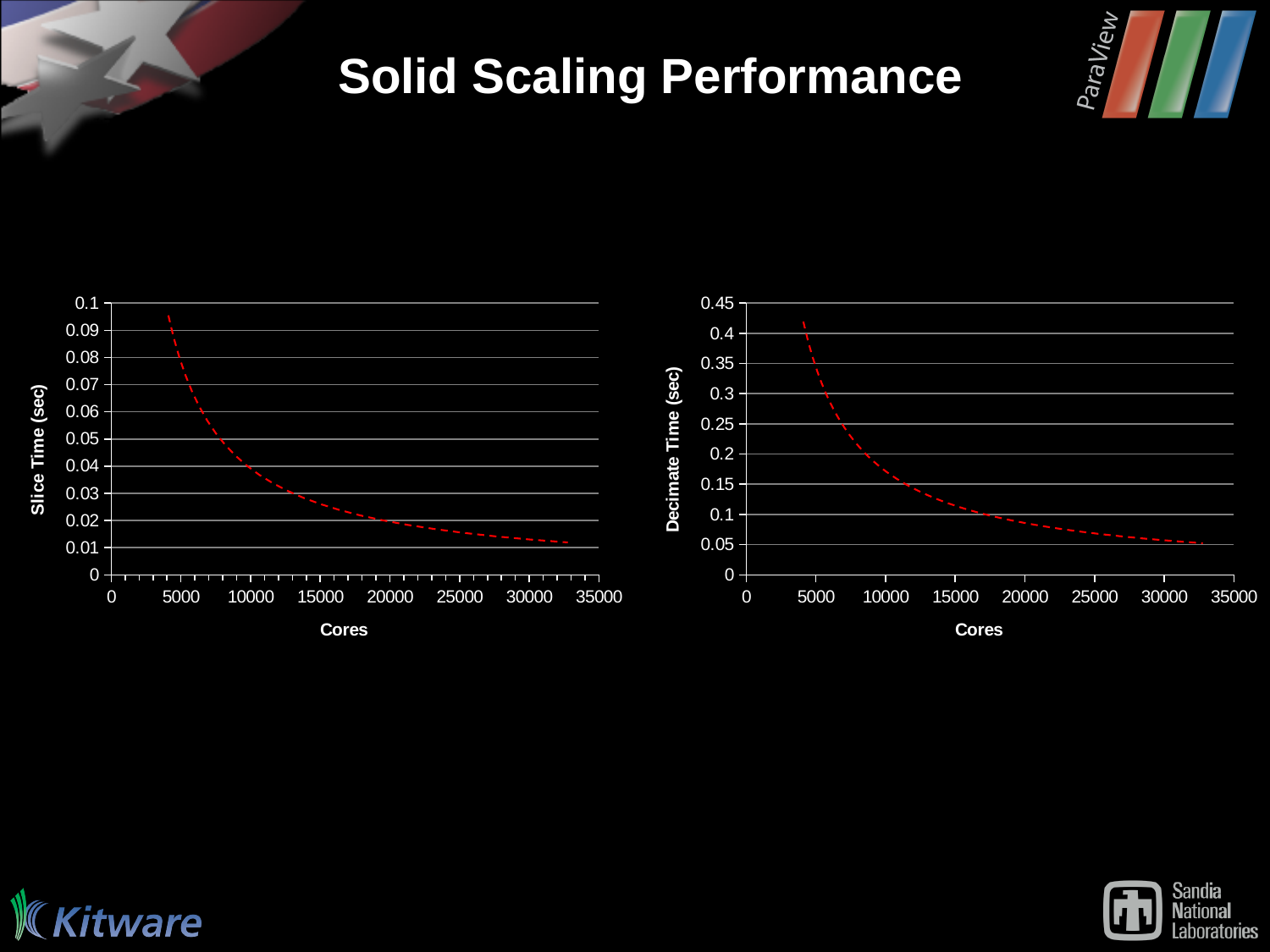
What kind of chart is the left chart (Slice Time vs Cores)? line chart How many charts are shown on the slide? 2 What is the y-axis label of the left chart? Slice Time (sec) In the left chart, does the slice time rise or fall as the number of cores increases? fall In the left chart, is the slice time at 30000 cores greater or less than 0.02 sec? less In the right chart, is the decimate time at 30000 cores greater or less than 0.1 sec? less In the right chart, is the decimate time at 5000 cores greater or less than 0.2 sec? greater What kind of chart is the right chart (Decimate Time vs Cores)? line chart In the right chart, does the decimate time rise or fall as the number of cores increases? fall What is the x-axis label of the right chart? Cores